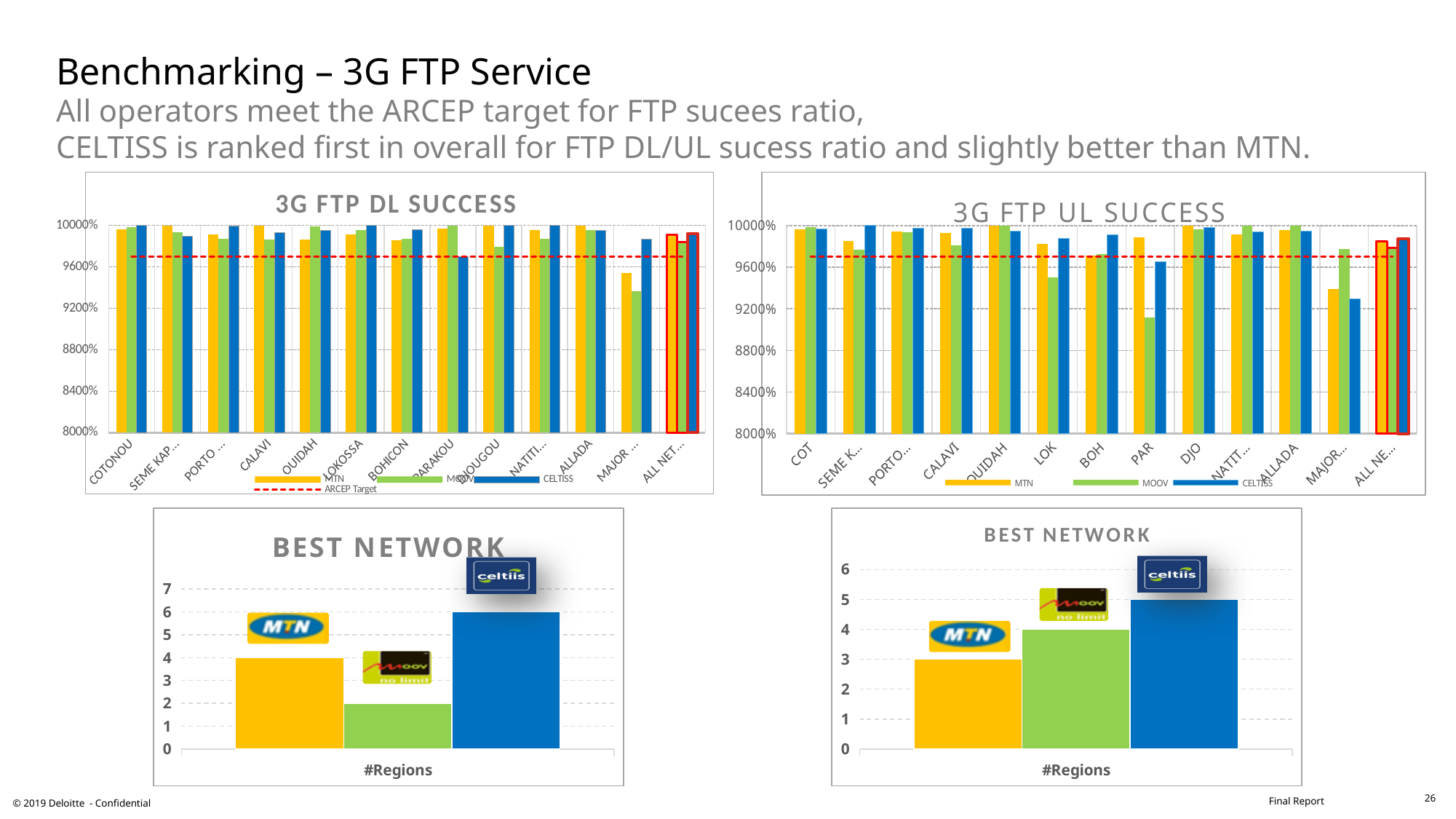
In the bottom-left BEST NETWORK chart, which operator has the highest bar? CELTISS In the 3G FTP UL SUCCESS chart, is the MOOV value for PAR greater or less than 9200%? less In the bottom-right BEST NETWORK chart, what is the difference between the CELTISS bar and the MTN bar? 2 In the bottom-left BEST NETWORK chart, what is the difference between the CELTISS bar and the MOOV bar? 4 In the 3G FTP DL SUCCESS chart, is the MOOV value for MAJOR... greater or less than 9600%? less In the bottom-left BEST NETWORK chart, what is the value of the MOOV bar? 2 In the bottom-right BEST NETWORK chart, what is the value of the CELTISS bar? 5 In the 3G FTP UL SUCCESS chart, how many series does the legend list? 3 In the bottom-right BEST NETWORK chart, which operator has the lowest bar? MTN In the 3G FTP DL SUCCESS chart, how many entries does the legend list? 4 What kind of chart is the 3G FTP UL SUCCESS chart? Bar chart In the bottom-left BEST NETWORK chart, what is the value of the MTN bar? 4